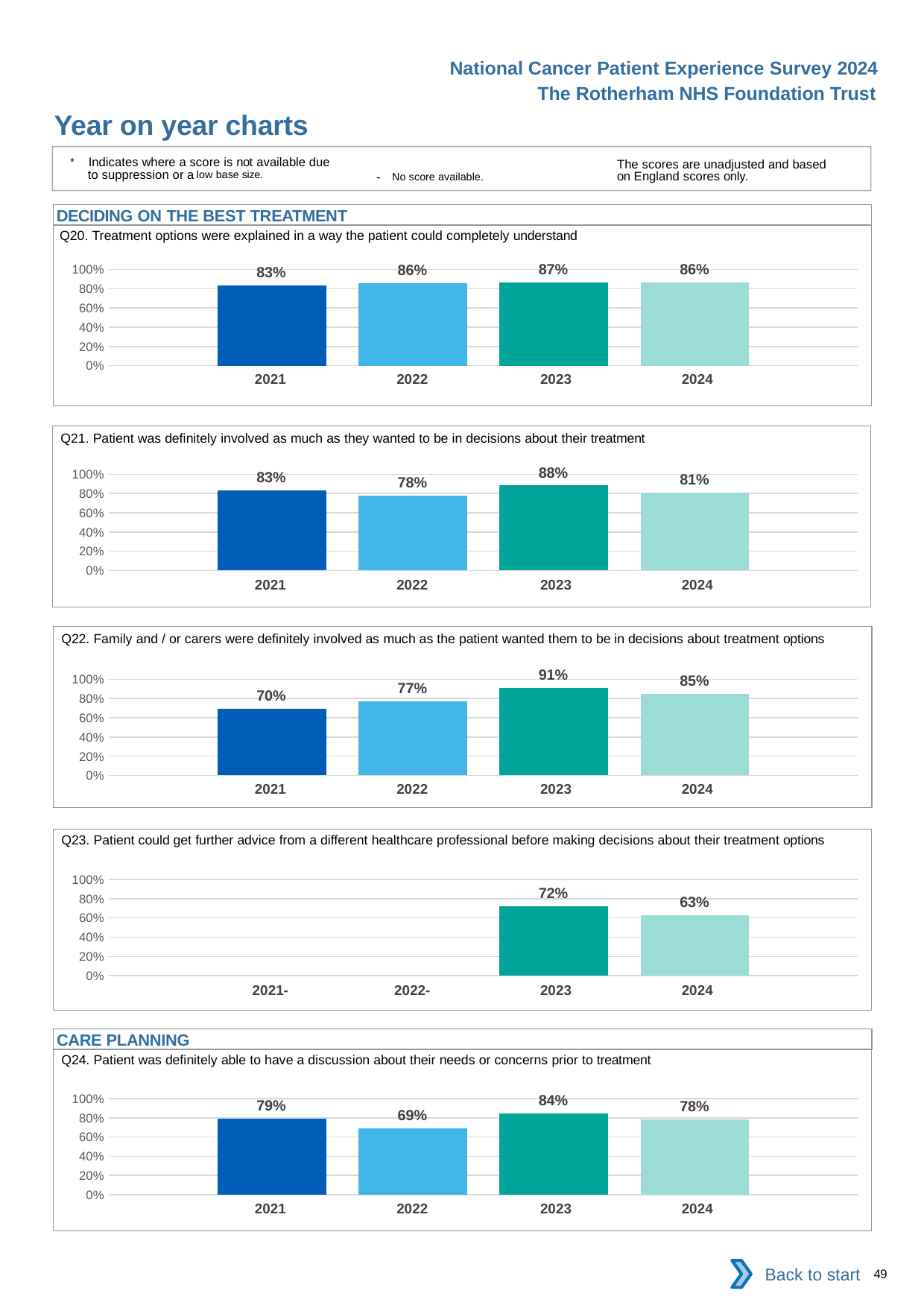
In the Q20 chart, what is the value for 2023? 87% In the Q24 chart, what is the value for 2022? 69% In the Q23 chart, what is the value for 2024? 63% In the Q22 chart, is the value for 2022 larger or smaller than the value for 2024? smaller In the Q22 chart, do the values rise or fall from 2021 to 2023? rise In the Q23 chart, how many years have a bar plotted? 2 In the Q21 chart, which year has the highest value? 2023 In the Q21 chart, which year has the lowest value? 2022 In the Q24 chart, which year has the highest value? 2023 In the Q20 chart, how many years are shown on the x axis? 4 What kind of chart is used for Q21? bar chart In the Q22 chart, what is the difference between the 2023 and 2021 values? 21%